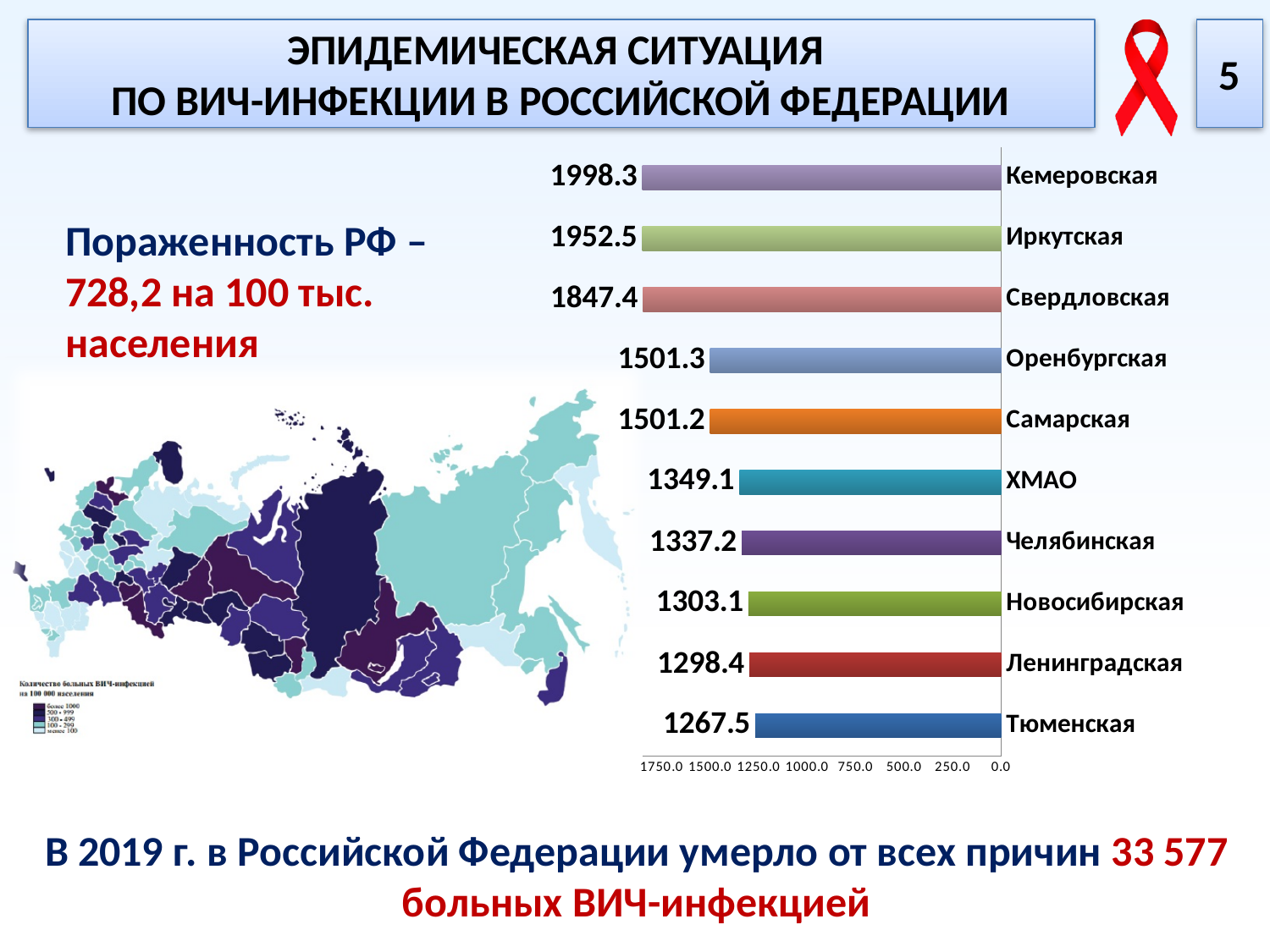
What is the difference between the values for Кемеровская and Иркутская? 45.8 Which region has the lowest value? Тюменская Which region has the highest value? Кемеровская What is the value for Новосибирская? 1303.1 What is the difference between the values for Кемеровская and Тюменская? 730.8 How many regions are shown in the bar chart? 10 What kind of chart is shown on the slide? bar chart What is the value for Кемеровская? 1998.3 What is the value for Самарская? 1501.2 What is the value for ХМАО? 1349.1 Which is larger, the value for Свердловская or the value for Челябинская? Свердловская Is the value for Ленинградская greater or less than 1500.0? less